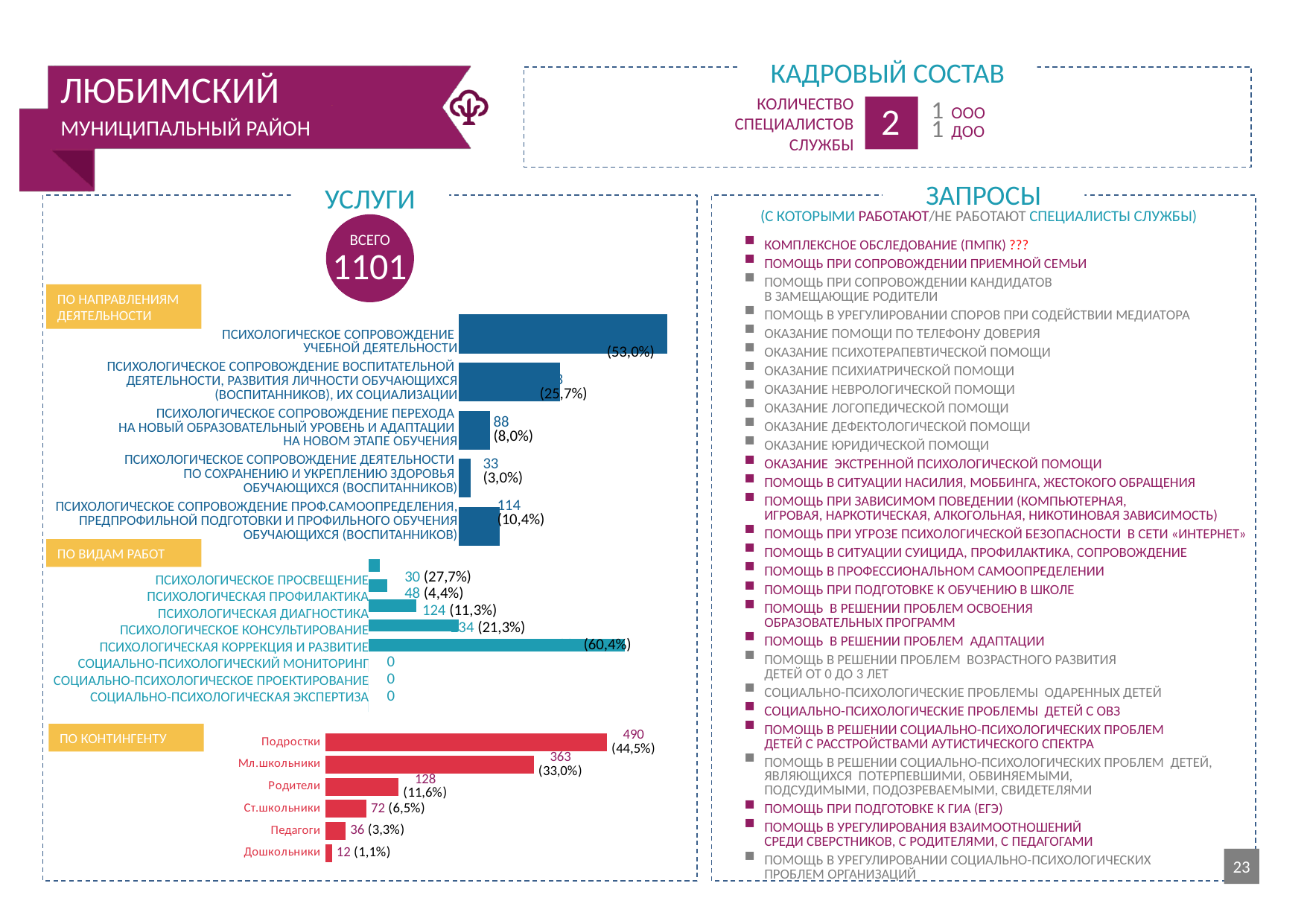
In the 'ПО КОНТИНГЕНТУ' chart, which category has the highest value? Подростки In the 'ПО НАПРАВЛЕНИЯМ ДЕЯТЕЛЬНОСТИ' chart, what is the value for психологическое сопровождение проф.самоопределения, предпрофильной подготовки и профильного обучения? 114 In the 'ПО НАПРАВЛЕНИЯМ ДЕЯТЕЛЬНОСТИ' chart, which is larger: the value for сопровождение перехода на новый образовательный уровень or for сопровождение деятельности по сохранению и укреплению здоровья? сопровождение перехода на новый образовательный уровень In the 'ПО НАПРАВЛЕНИЯМ ДЕЯТЕЛЬНОСТИ' chart, what percentage is shown for психологическое сопровождение учебной деятельности? 53,0% In the 'ПО КОНТИНГЕНТУ' chart, what is the value for Подростки? 490 What kind of chart is the 'ПО КОНТИНГЕНТУ' chart? bar chart In the 'ПО КОНТИНГЕНТУ' chart, what percentage is shown for Мл.школьники? 33,0% In the 'ПО ВИДАМ РАБОТ' chart, what percentage is shown for психологическая коррекция и развитие? 60,4% In the 'ПО ВИДАМ РАБОТ' chart, what is the value for психологическая диагностика? 124 In the 'ПО КОНТИНГЕНТУ' chart, what is the difference between the values for Подростки and Мл.школьники? 127 In the 'ПО КОНТИНГЕНТУ' chart, how many categories are shown? 6 In the 'ПО КОНТИНГЕНТУ' chart, which category has the lowest value? Дошкольники